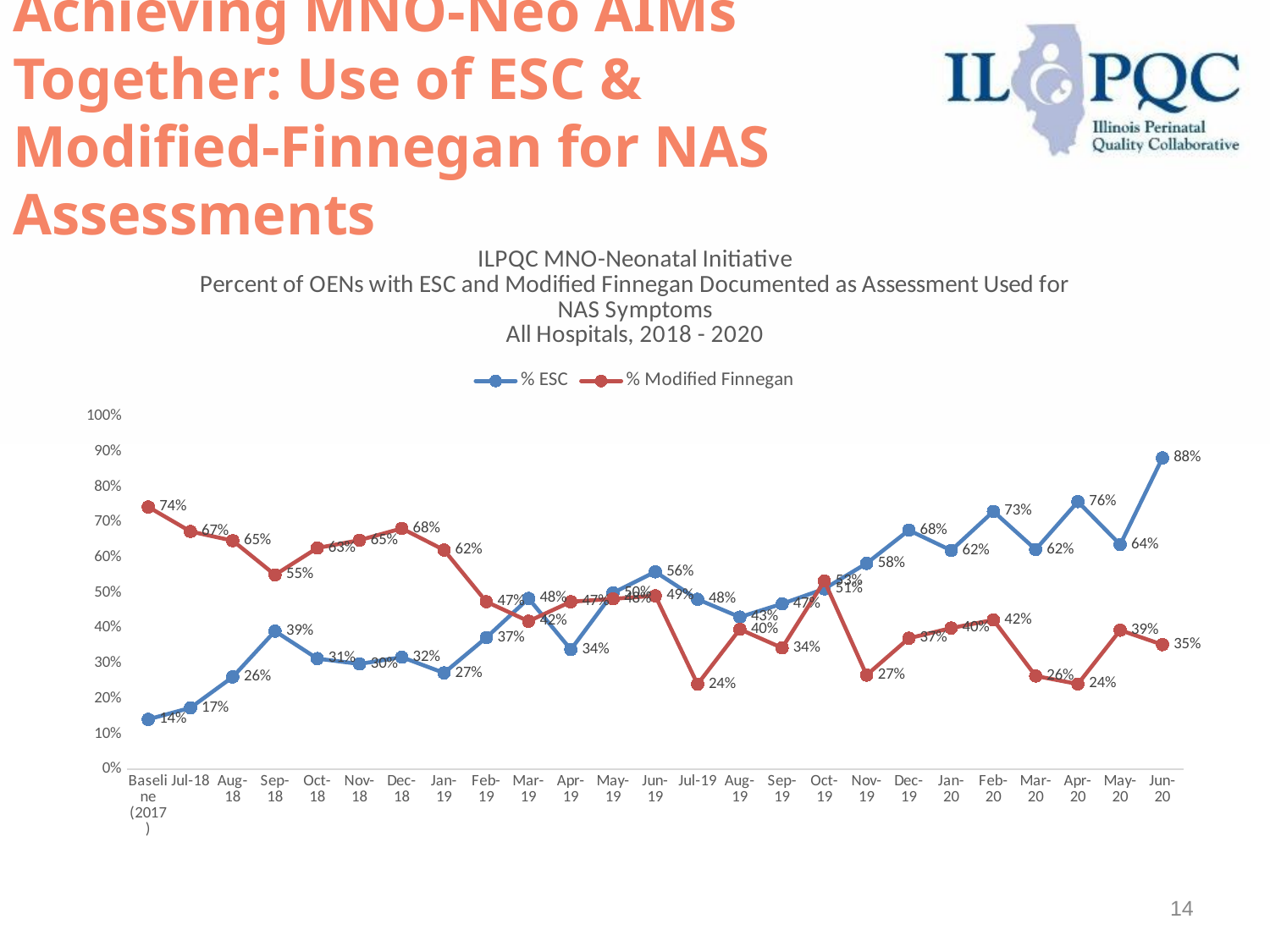
In which month is the % ESC value highest? Jun-20 How many series does the legend list? 2 Overall, does the % ESC line rise or fall from Baseline (2017) to Jun-20? Rise What is the difference between % ESC and % Modified Finnegan in Jun-20? 53 percentage points At which point is the % ESC value lowest? Baseline (2017) What kind of chart is shown on the slide? Line chart At which point is the % Modified Finnegan value highest? Baseline (2017) In Sep-18, which series has the larger value, % ESC or % Modified Finnegan? % Modified Finnegan What is the % ESC value for Jun-20? 88% What colour is the % ESC line? Blue What is the % Modified Finnegan value at Baseline (2017)? 74% What is the % Modified Finnegan value for Jul-19? 24%